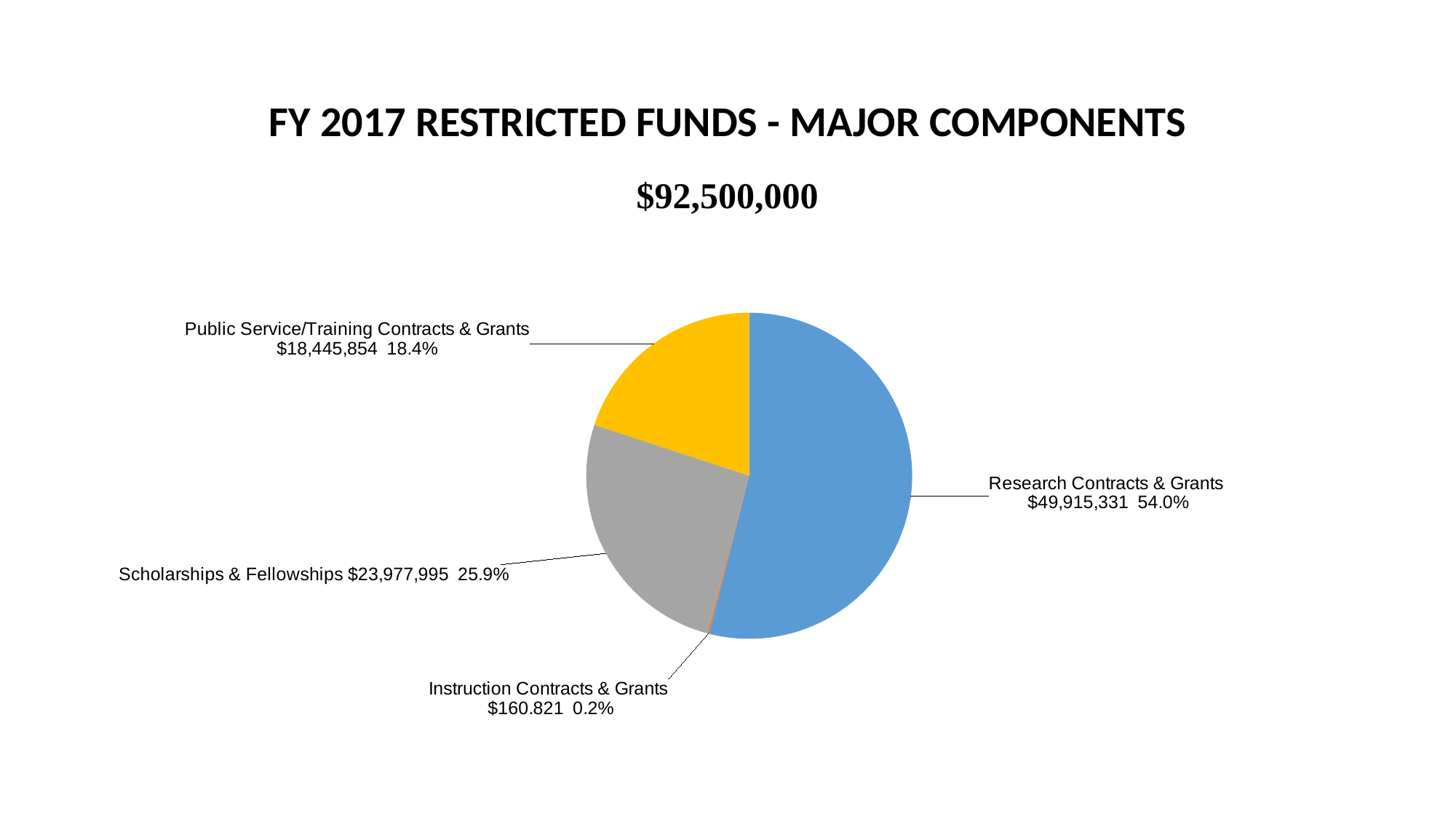
What is the dollar value for Research Contracts & Grants? $49,915,331 What total amount is shown below the chart title? $92,500,000 What type of chart is shown on the slide? Pie chart What percentage share does Instruction Contracts & Grants have? 0.2% Which component has the smallest share of the pie? Instruction Contracts & Grants What colour is the Research Contracts & Grants slice? Blue How many slices does the pie chart have? 4 What is the dollar value for Public Service/Training Contracts & Grants? $18,445,854 Which is larger, Scholarships & Fellowships or Public Service/Training Contracts & Grants? Scholarships & Fellowships Which component has the largest share of the pie? Research Contracts & Grants What percentage share does Scholarships & Fellowships have? 25.9% What is the difference in dollars between Research Contracts & Grants and Scholarships & Fellowships? $25,937,336